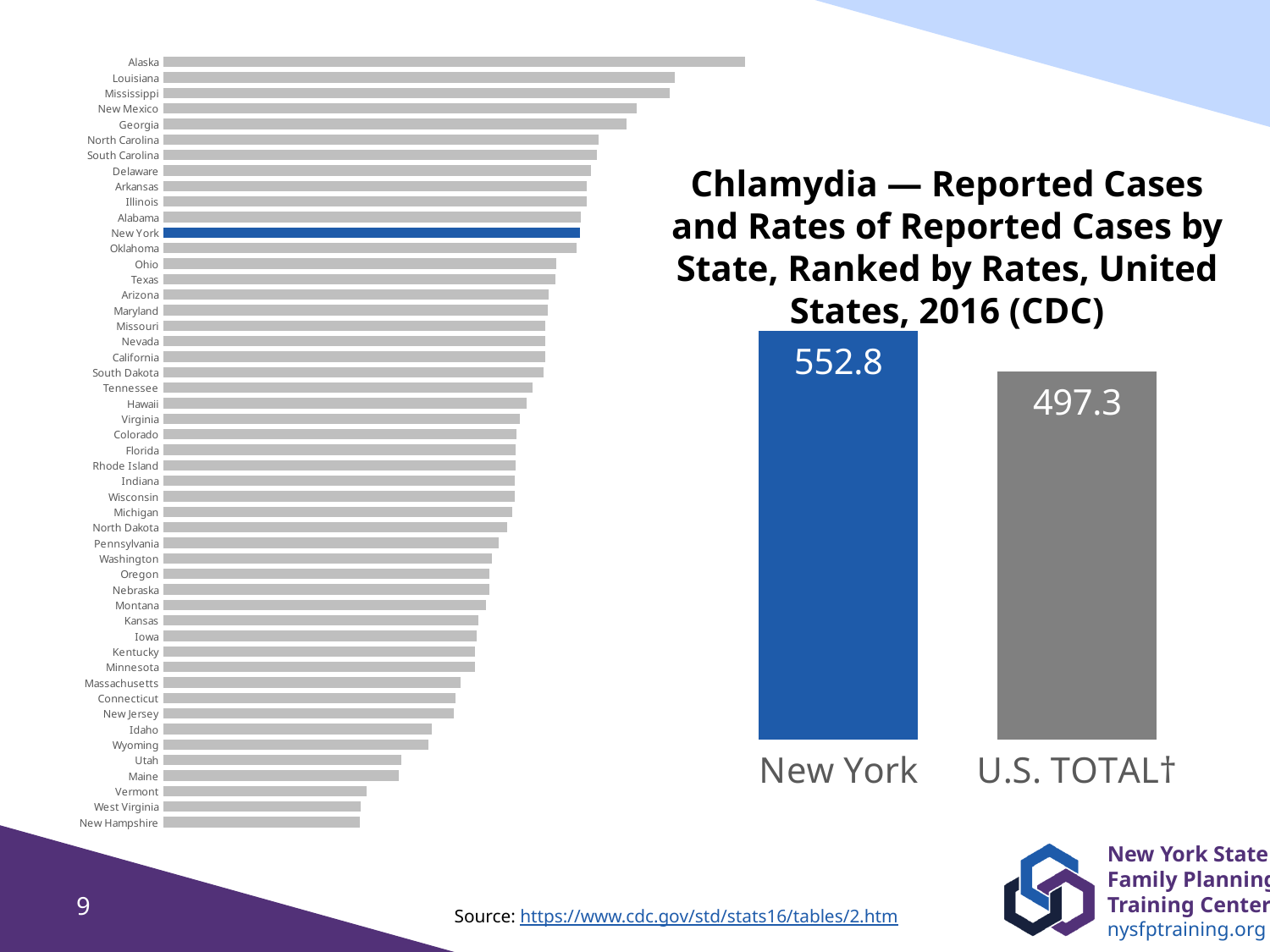
On the left-hand chart ranking states, which has the longer bar, Louisiana or Vermont? Louisiana What kind of chart is the right-hand chart? Bar chart What kind of chart is the left-hand chart ranking states? Bar chart On the left-hand chart ranking states, which state has the shortest bar? New Hampshire On the right-hand chart, how many bars are plotted? 2 On the left-hand chart ranking states, how many states are listed? 50 On the right-hand chart, which is larger, New York or U.S. TOTAL†? New York On the left-hand chart ranking states, which state's bar is highlighted in blue? New York On the left-hand chart ranking states, which state has the longest bar? Alaska On the right-hand chart, what is the value shown for U.S. TOTAL†? 497.3 On the right-hand chart, what is the value shown for New York? 552.8 On the right-hand chart, what is the difference between the New York value and the U.S. TOTAL† value? 55.5